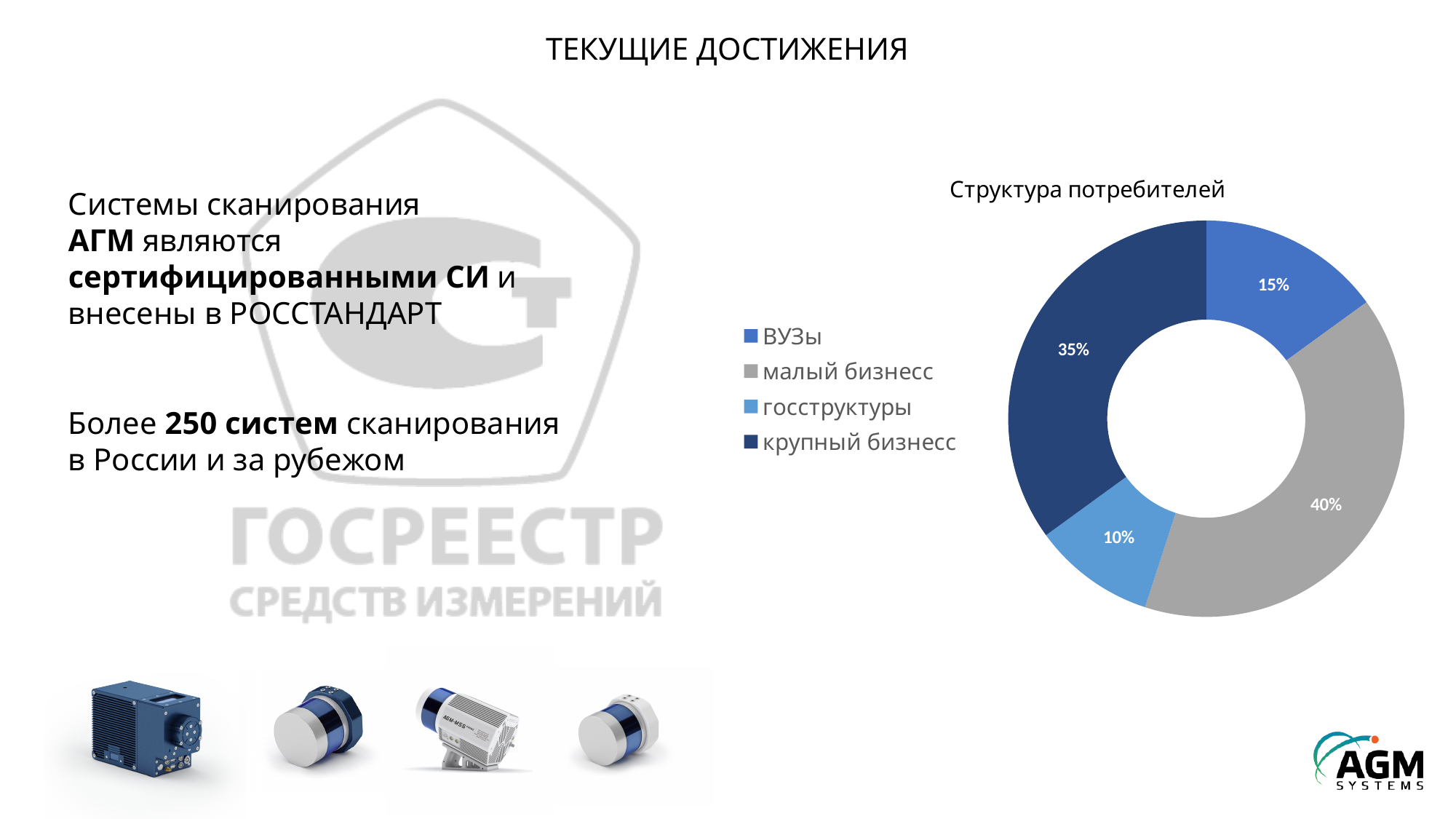
What is the title of the chart on the slide? Структура потребителей What is the difference in percentage points between малый бизнесс and крупный бизнесс? 5 How many consumer categories are shown in the chart? 4 What type of chart is used to show the consumer structure? Doughnut (pie) chart What share of consumers do ВУЗы represent in the 'Структура потребителей' chart? 15% Which consumer category has the smallest share? госструктуры What share of consumers do госструктуры represent? 10% What share of consumers does крупный бизнесс represent? 35% What share of consumers does малый бизнесс represent? 40% Which has a larger share, ВУЗы or крупный бизнесс? крупный бизнесс Which consumer category has the largest share? малый бизнесс What colour represents малый бизнесс in the chart? Grey